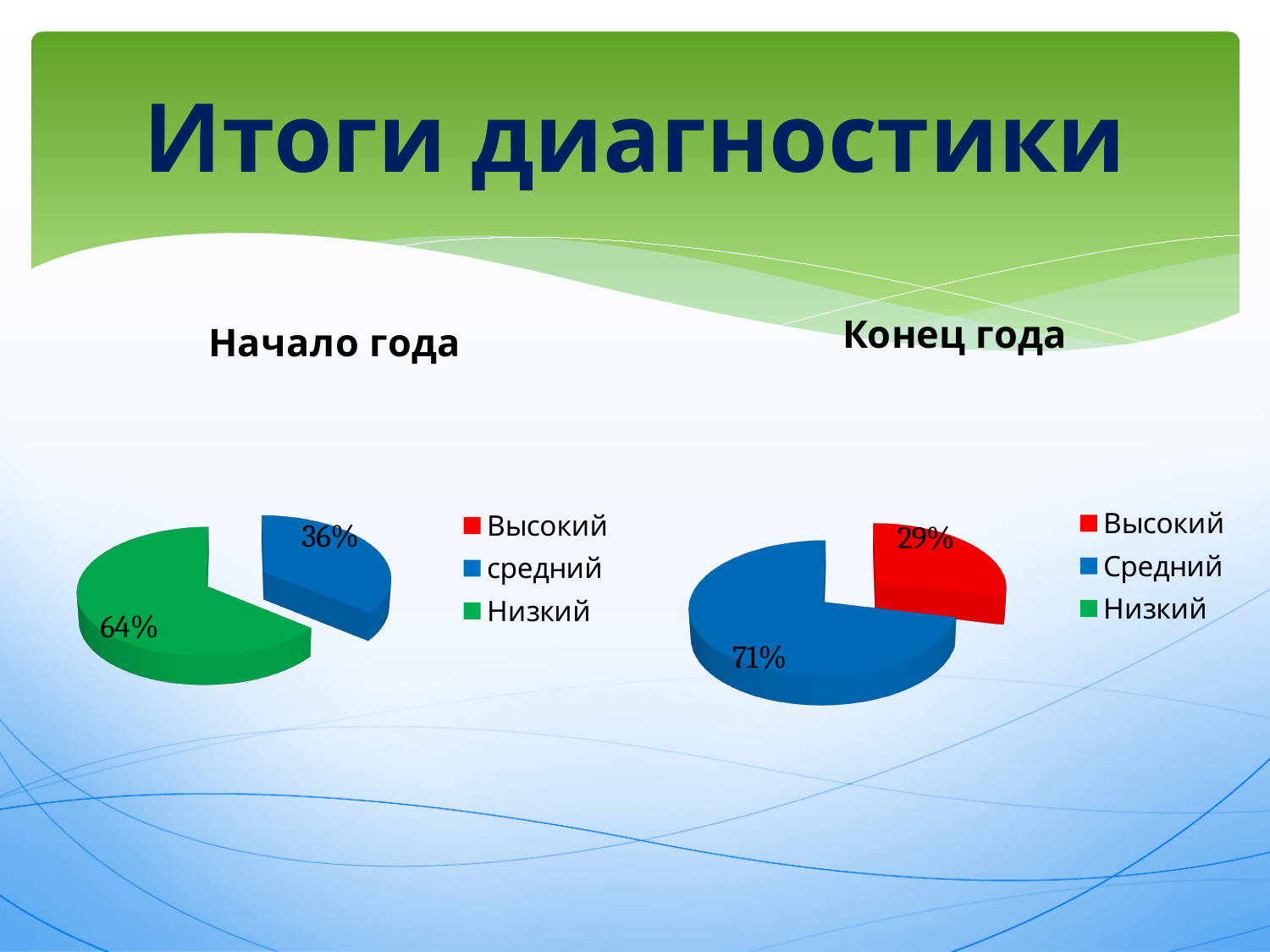
In the "Начало года" chart, which category has the largest slice? Низкий In the "Начало года" chart, what share does the "средний" slice have? 36% Which is larger: the "средний" share in the "Начало года" chart or the "Средний" share in the "Конец года" chart? Конец года In the "Конец года" chart, what share does the "Высокий" slice have? 29% In the "Конец года" chart, which category has the smallest slice? Высокий In the "Начало года" chart, what is the difference between the "Низкий" and "средний" shares? 28% In the "Конец года" chart, what is the difference between the "Средний" and "Высокий" shares? 42% How many entries does the legend of the "Начало года" chart list? 3 In the "Начало года" chart, what share does the "Низкий" slice have? 64% In the "Конец года" chart, what colour is the "Высокий" slice? Red What type of chart is the "Конец года" chart? Pie chart In the "Конец года" chart, what share does the "Средний" slice have? 71%